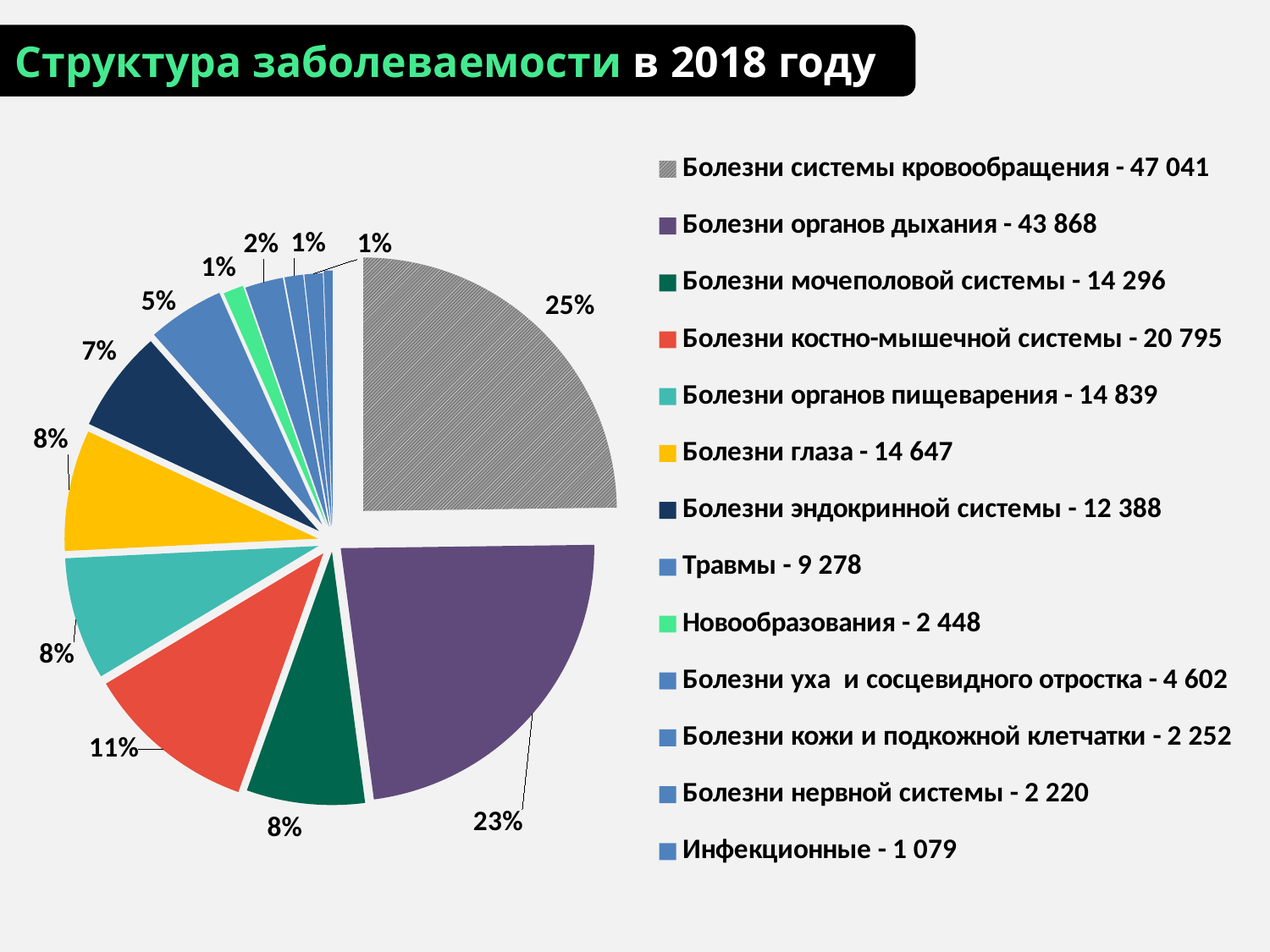
Which is larger, the value for Болезни органов пищеварения or the value for Болезни мочеполовой системы? Болезни органов пищеварения What value is given in the legend for Травмы? 9 278 Which category has the smallest value in the legend? Инфекционные What is the difference between the legend values for Болезни системы кровообращения and Болезни органов дыхания? 3 173 What value is given in the legend for Болезни глаза? 14 647 Which category has the largest slice of the pie? Болезни системы кровообращения What share of the pie does Болезни костно-мышечной системы take? 11% What kind of chart is shown on the slide? pie chart What is the title of the slide? Структура заболеваемости в 2018 году How many categories does the legend of the pie chart list? 13 What value is given in the legend for Болезни системы кровообращения? 47 041 What share of the pie does Болезни органов дыхания take? 23%